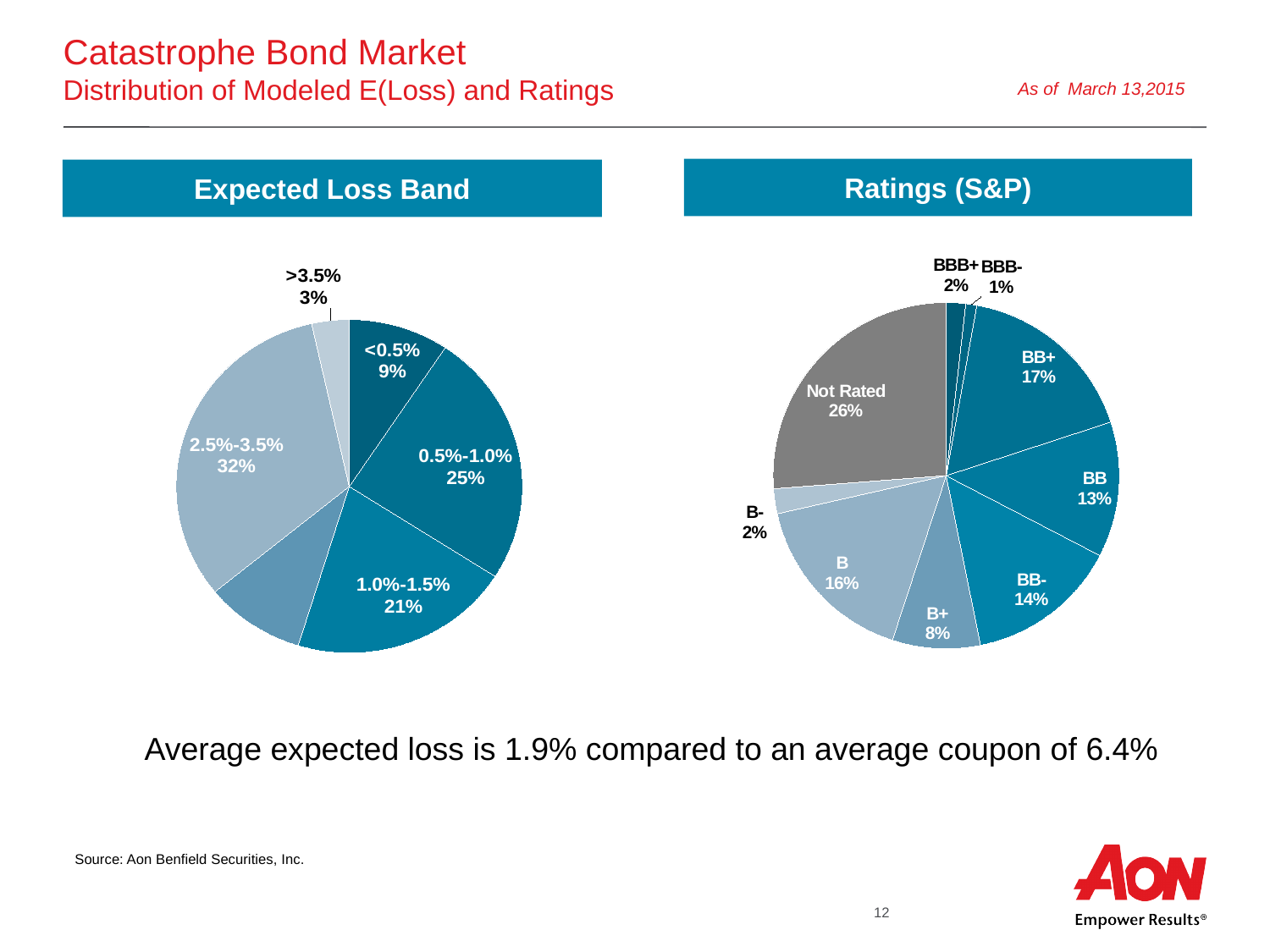
What type of chart is used for the Ratings (S&P) data? Pie chart In the Ratings (S&P) chart, which rating category has the smallest share? BBB- How many slices does the Ratings (S&P) pie chart have? 9 In the Ratings (S&P) chart, what share of the pie is Not Rated? 26% In the Expected Loss Band chart, which band has the smallest share? >3.5% In the Expected Loss Band chart, what is the difference in percentage points between the 0.5%-1.0% band and the 1.0%-1.5% band? 4 In the Expected Loss Band chart, what percentage is shown for the 0.5%-1.0% band? 25% In the Ratings (S&P) chart, which is larger: BB or BB-? BB- In the Expected Loss Band chart, what share of the pie is the 2.5%-3.5% band? 32% In the Expected Loss Band chart, which band has the largest share? 2.5%-3.5% In the Ratings (S&P) chart, what percentage is shown for BB+? 17% In the Expected Loss Band chart, which is larger: the <0.5% band or the 1.0%-1.5% band? 1.0%-1.5%